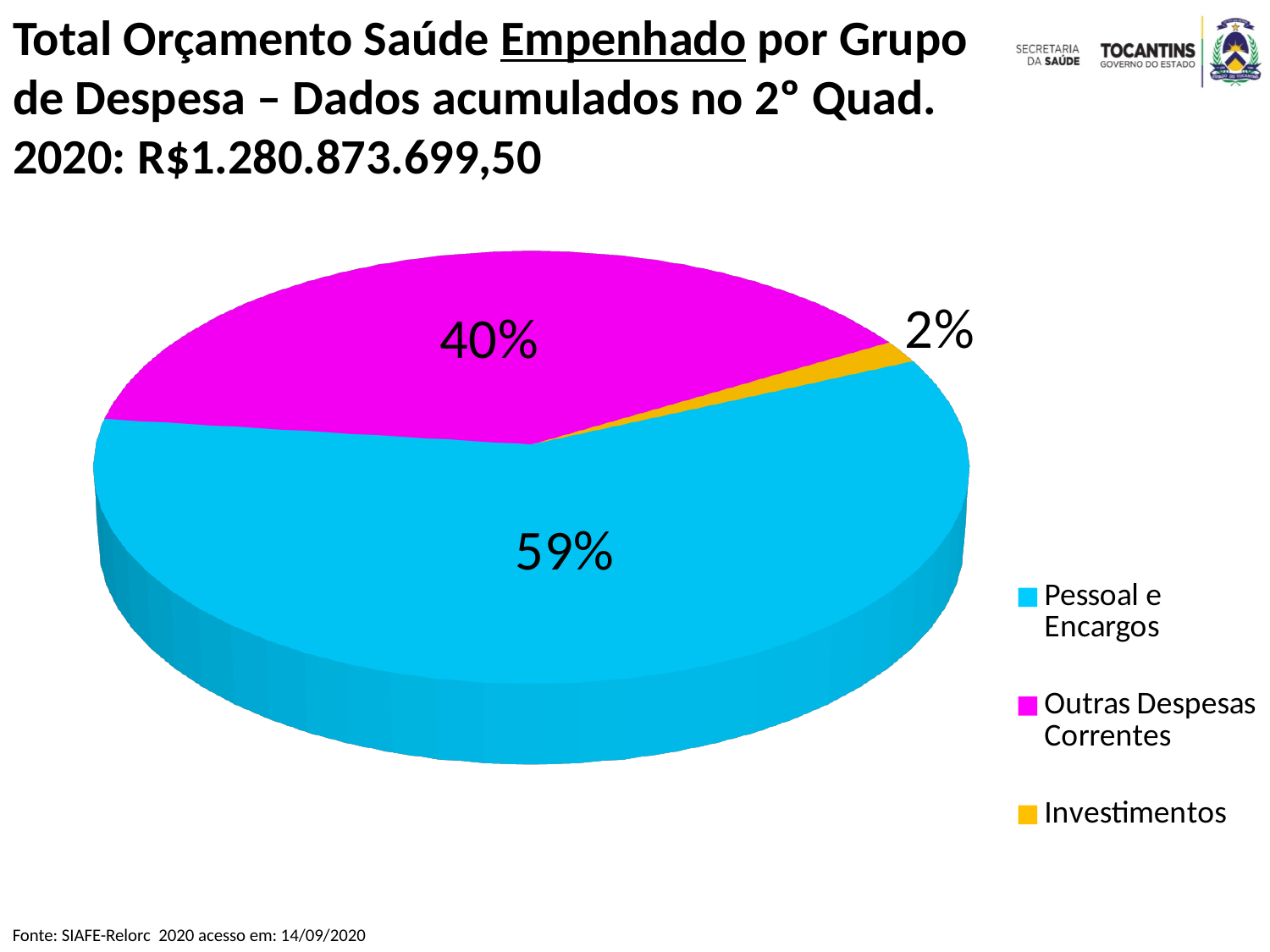
What colour is the slice for Investimentos? Yellow What share of the pie does Pessoal e Encargos represent? 59% What share of the pie does Outras Despesas Correntes represent? 40% Which expense group has the largest slice of the pie? Pessoal e Encargos Which expense group has the smallest slice of the pie? Investimentos What total amount is stated in the slide title for the committed health budget? R$1.280.873.699,50 What is the difference in percentage points between Pessoal e Encargos and Outras Despesas Correntes? 19 What kind of chart is shown on the slide? Pie chart How many expense groups are shown in the pie chart? 3 Which is larger, the share for Outras Despesas Correntes or the share for Investimentos? Outras Despesas Correntes What share of the pie does Investimentos represent? 2%